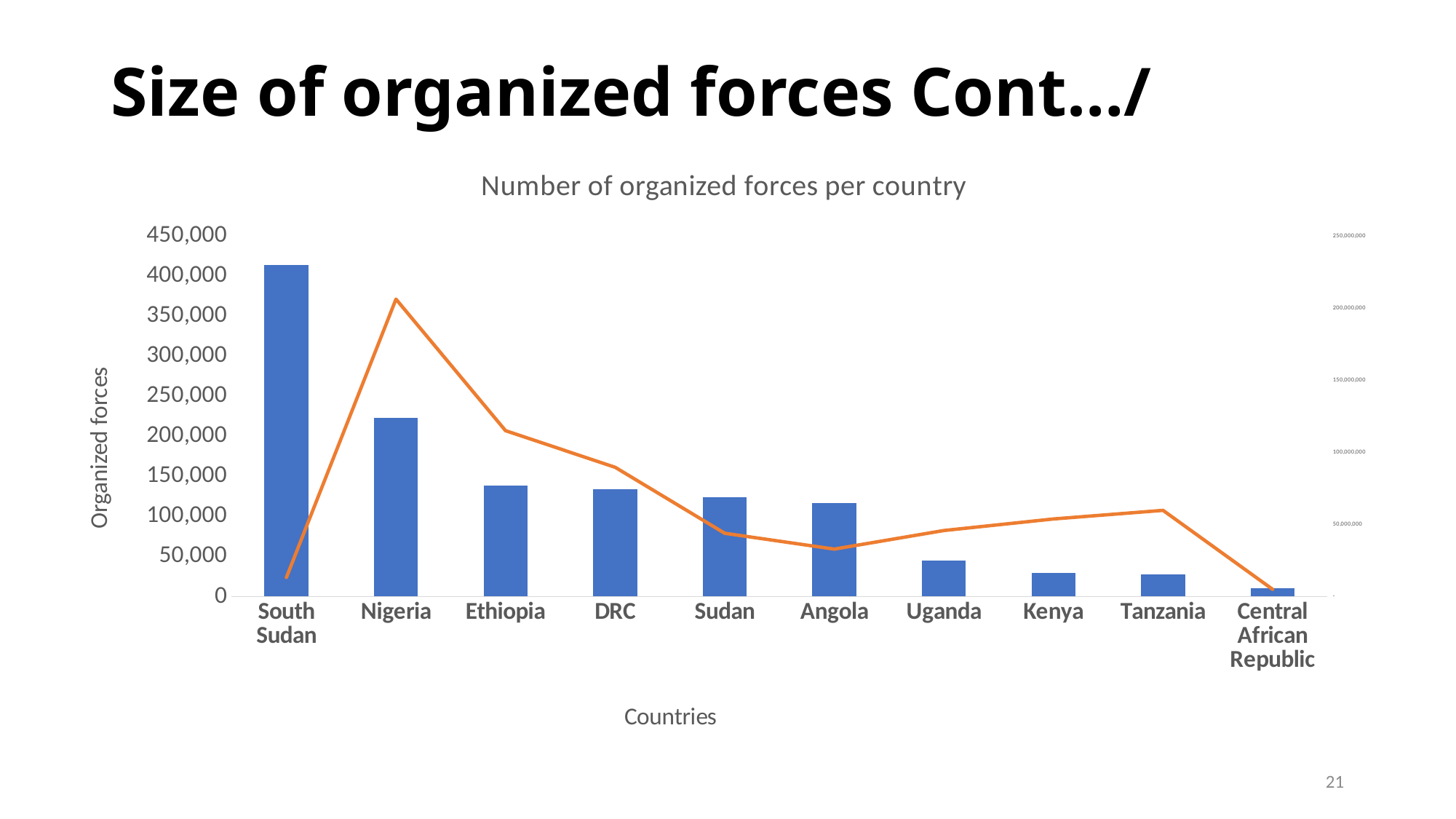
What kind of chart is shown on the slide? A bar chart with a line overlay Is the bar value for Nigeria greater or less than 250,000? less Which has the larger bar, Nigeria or Ethiopia? Nigeria Is the bar value for Uganda greater or less than 50,000? less Which country has the tallest bar in the chart? South Sudan Is the bar value for Angola greater or less than 100,000? greater Which country has the shortest bar in the chart? Central African Republic How many countries are shown on the x axis of the chart? 10 What is the label on the vertical axis of the chart? Organized forces What is the title of the chart? Number of organized forces per country Do the bar values generally rise or fall from left to right across the countries? fall